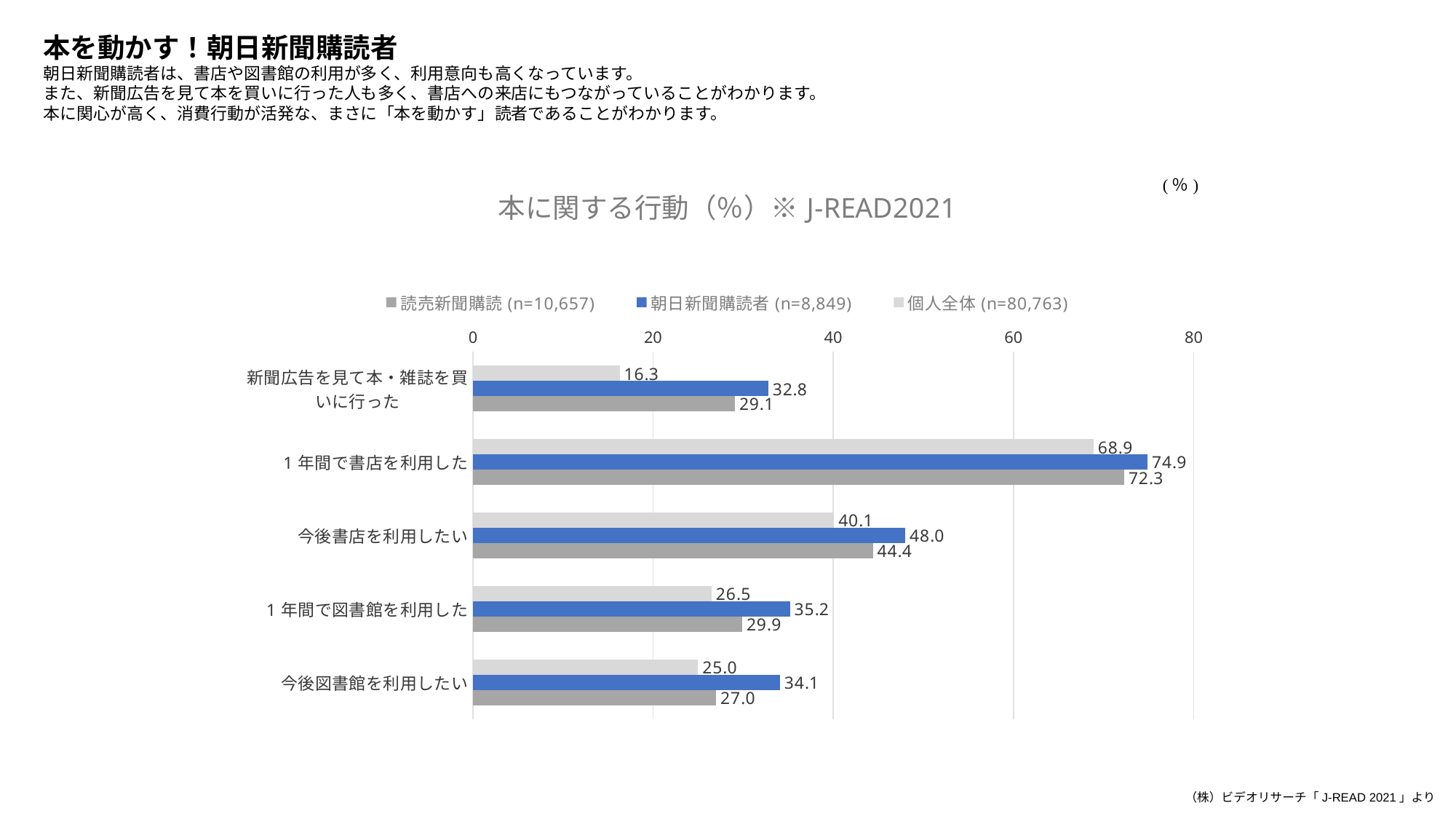
In the category 1年間で図書館を利用した, which is larger: 朝日新聞購読者 or 読売新聞購読? 朝日新聞購読者 What is the value for 読売新聞購読 in the category 今後図書館を利用したい? 27.0 Is the value for 読売新聞購読 in the category 1年間で書店を利用した greater or less than 60? greater What kind of chart is shown on the slide? bar chart Which category has the lowest value for 個人全体? 新聞広告を見て本・雑誌を買いに行った How many categories are shown on the chart? 5 What is the value for 個人全体 in the category 新聞広告を見て本・雑誌を買いに行った? 16.3 What is the difference between 朝日新聞購読者 and 個人全体 in the category 今後書店を利用したい? 7.9 Which category has the highest value for 朝日新聞購読者? 1年間で書店を利用した What is the title of the chart? 本に関する行動（%）※ J-READ2021 How many series does the legend list? 3 What is the value for 朝日新聞購読者 in the category 1年間で書店を利用した? 74.9